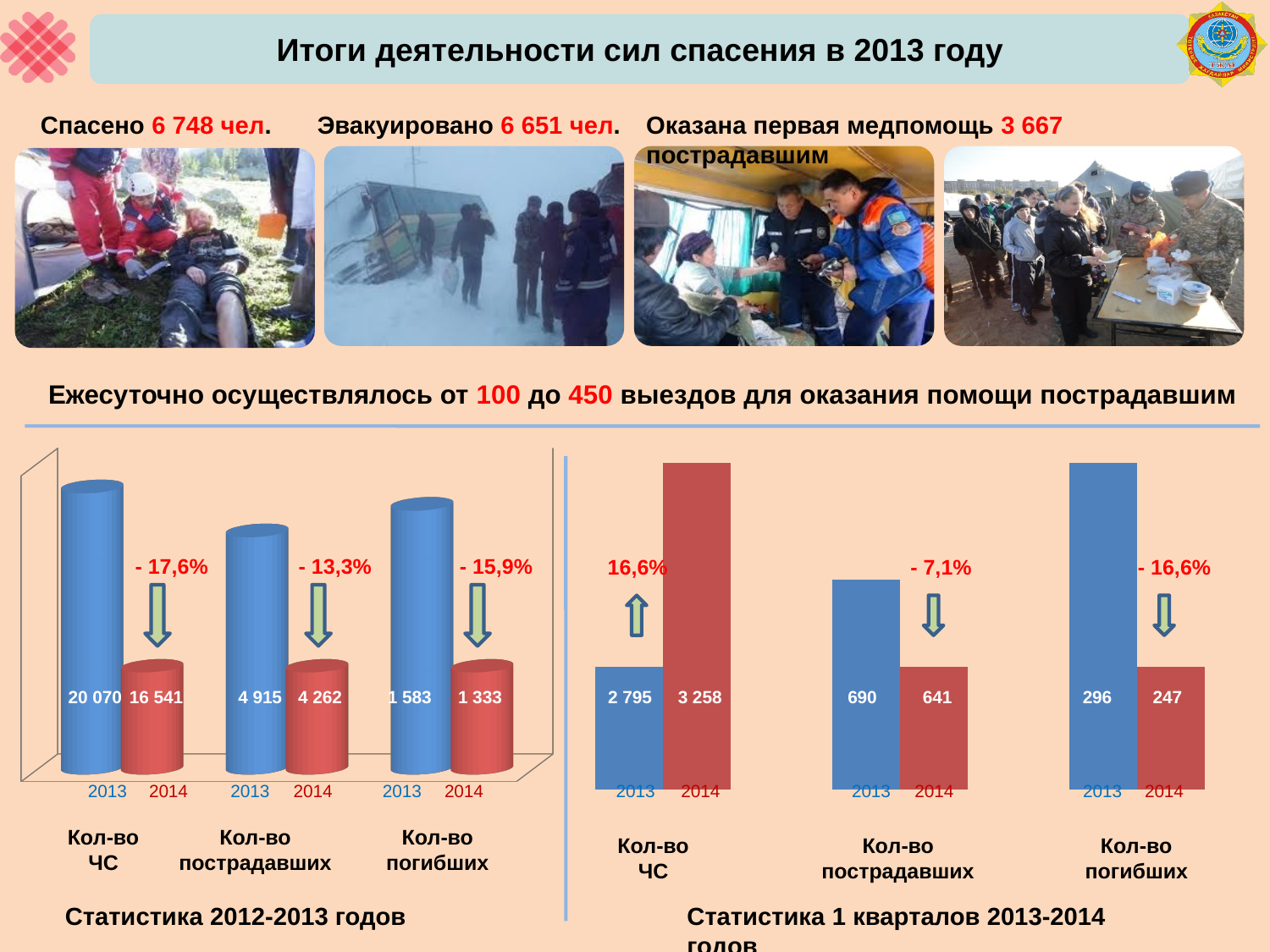
What type of chart is the left chart (Статистика 2012-2013 годов)? Bar chart In the left chart (Статистика 2012-2013 годов), what percentage change is shown for Кол-во погибших? - 15,9% In the right chart (Статистика 1 кварталов 2013-2014 годов), what is the value for Кол-во погибших in 2013? 296 In the left chart (Статистика 2012-2013 годов), what is the value for Кол-во ЧС in 2013? 20 070 In the right chart (Статистика 1 кварталов 2013-2014 годов), which is larger for Кол-во ЧС: the 2013 value or the 2014 value? 2014 In the left chart (Статистика 2012-2013 годов), what is the difference between the 2013 and 2014 values for Кол-во погибших? 250 In the right chart (Статистика 1 кварталов 2013-2014 годов), what is the difference between the 2013 and 2014 values for Кол-во пострадавших? 49 How many categories are shown in the right chart (Статистика 1 кварталов 2013-2014 годов)? 3 In the right chart (Статистика 1 кварталов 2013-2014 годов), what percentage change is shown for Кол-во ЧС? 16,6% In the left chart (Статистика 2012-2013 годов), what is the value for Кол-во пострадавших in 2014? 4 262 In the left chart (Статистика 2012-2013 годов), which category has the highest 2013 value? Кол-во ЧС In the right chart (Статистика 1 кварталов 2013-2014 годов), what is the value for Кол-во ЧС in 2014? 3 258